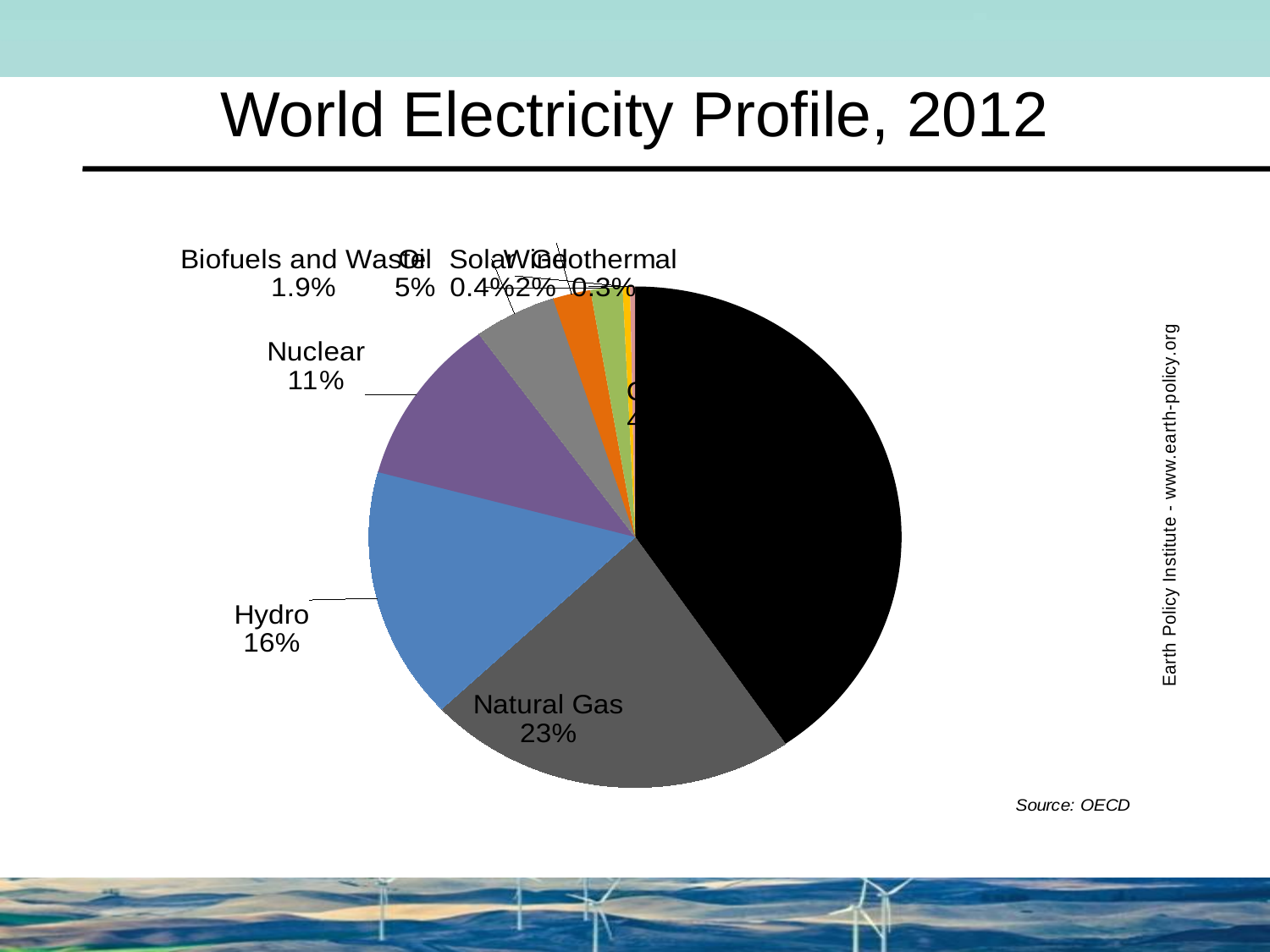
What kind of chart is shown on the slide? pie chart What percentage is shown for Geothermal in the pie chart? 0.3% What is the title of the chart on the slide? World Electricity Profile, 2012 What percentage is shown for Hydro in the pie chart? 16% Which labelled source has the smallest share in the pie chart? Geothermal What percentage is shown for Nuclear in the pie chart? 11% Which has the larger share in the pie chart, Hydro or Nuclear? Hydro By how many percentage points does Natural Gas exceed Hydro in the pie chart? 7 percentage points What percentage is shown for Oil in the pie chart? 5% What percentage is shown for Biofuels and Waste in the pie chart? 1.9% What share of world electricity does Natural Gas account for in the pie chart? 23% What percentage is shown for Wind in the pie chart? 2%